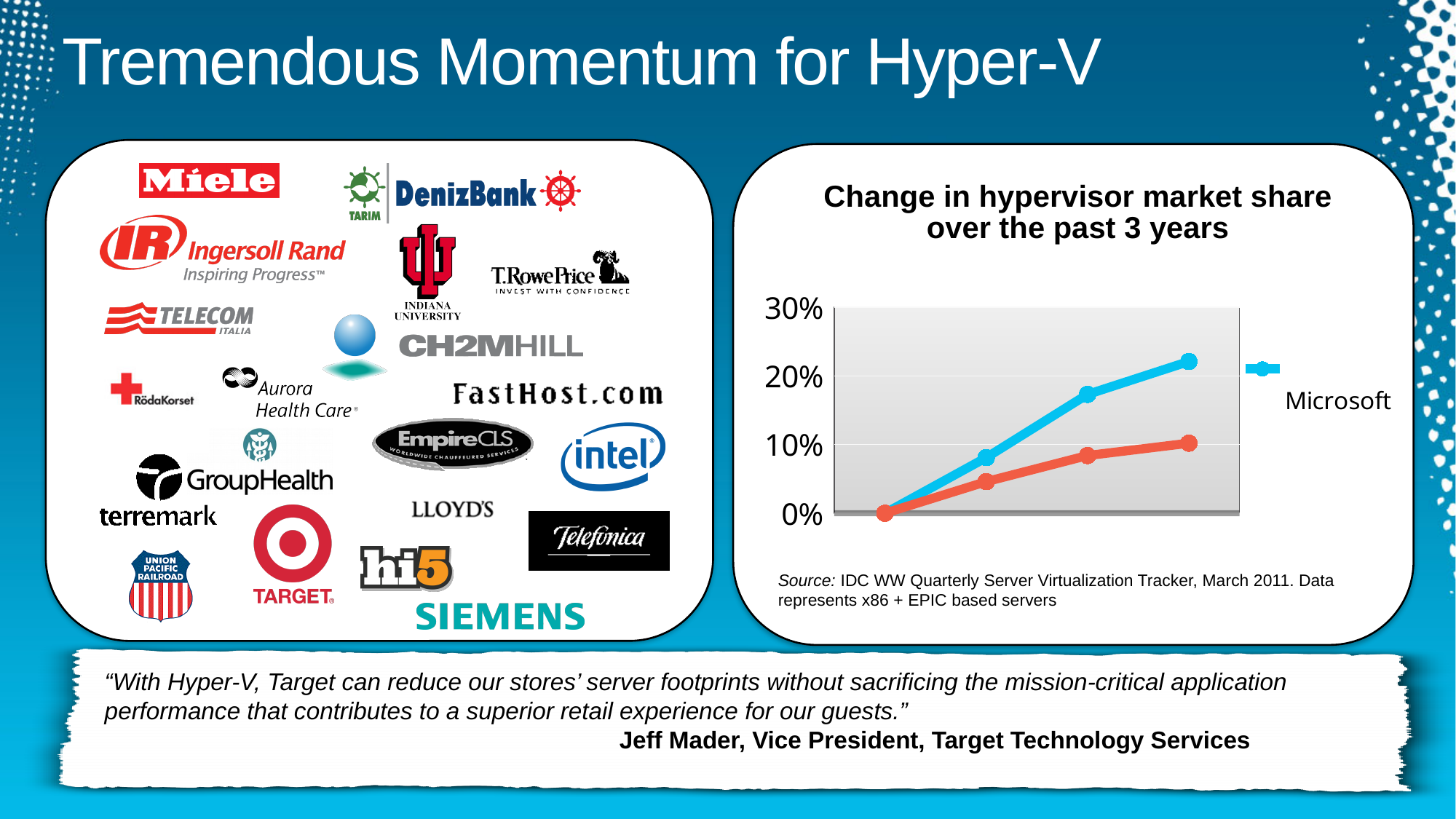
What is the title of the chart on the right side of the slide? Change in hypervisor market share over the past 3 years What is the highest value shown on the chart's vertical axis? 30% At the final point, which line is higher: the Microsoft line or the orange line? Microsoft Is the second point of the Microsoft line greater or less than 10%? less Is the third point of the orange line greater or less than 10%? less What kind of chart is shown under the title 'Change in hypervisor market share over the past 3 years'? line chart How many data points does the Microsoft line have? 4 Which series name is readable in the chart's legend? Microsoft Does the Microsoft line rise or fall from left to right? rise Does the orange line rise or fall from left to right? rise Is the final value of the Microsoft line greater or less than 20%? greater